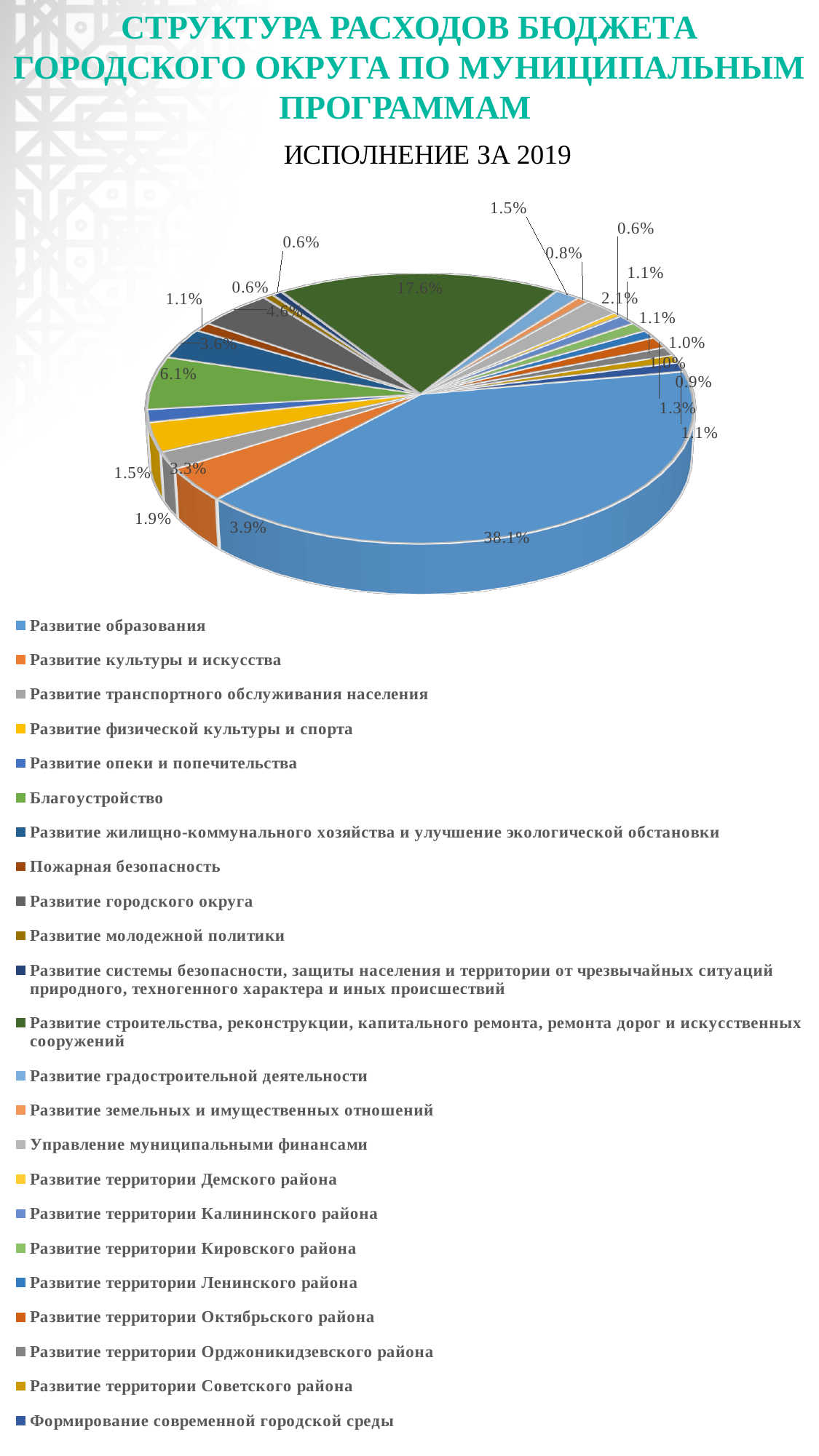
How many programmes are listed in the chart legend? 23 What share is shown for Благоустройство? 6.1% What is the largest share shown on the pie chart? 38.1% Which is larger: the share for Развитие образования or the share for Развитие строительства, реконструкции, капитального ремонта, ремонта дорог и искусственных сооружений? Развитие образования Which programme has the largest share of budget expenditure on the pie chart? Развитие образования What is the subtitle printed directly above the chart? ИСПОЛНЕНИЕ ЗА 2019 What share of expenditure is shown for Развитие образования? 38.1% What kind of chart is shown on the slide? Pie chart Which year's execution does the chart show? 2019 What share is shown for the dark green slice, Развитие строительства, реконструкции, капитального ремонта, ремонта дорог и искусственных сооружений? 17.6% By how many percentage points does the 38.1% slice exceed the 17.6% slice? 20.5%